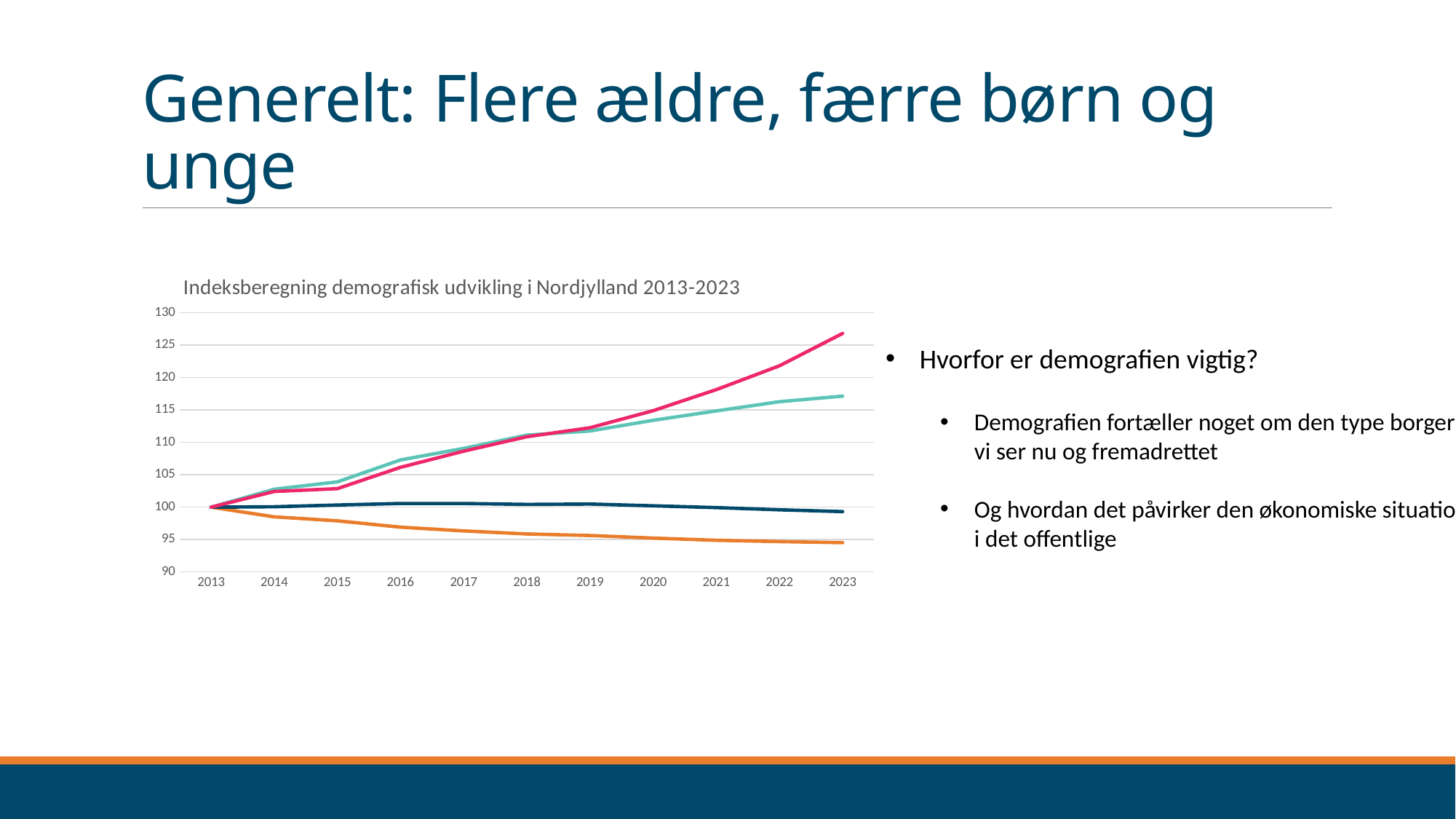
Is the value of the pink line in 2023 greater or less than 125? greater Does the pink line rise or fall from 2013 to 2023? rise How many lines are plotted in the chart? 4 How many years are shown along the x axis of the chart? 11 Which line has the highest value in 2023? the pink line What kind of chart is shown on the slide? line chart Is the value of the orange line in 2023 greater or less than 100? less Does the orange line rise or fall from 2013 to 2023? fall What value do all the lines start at in 2013? 100 Is the value of the teal line in 2023 greater or less than 115? greater What is the title of the chart? Indeksberegning demografisk udvikling i Nordjylland 2013-2023 Which line has the lowest value in 2023? the orange line